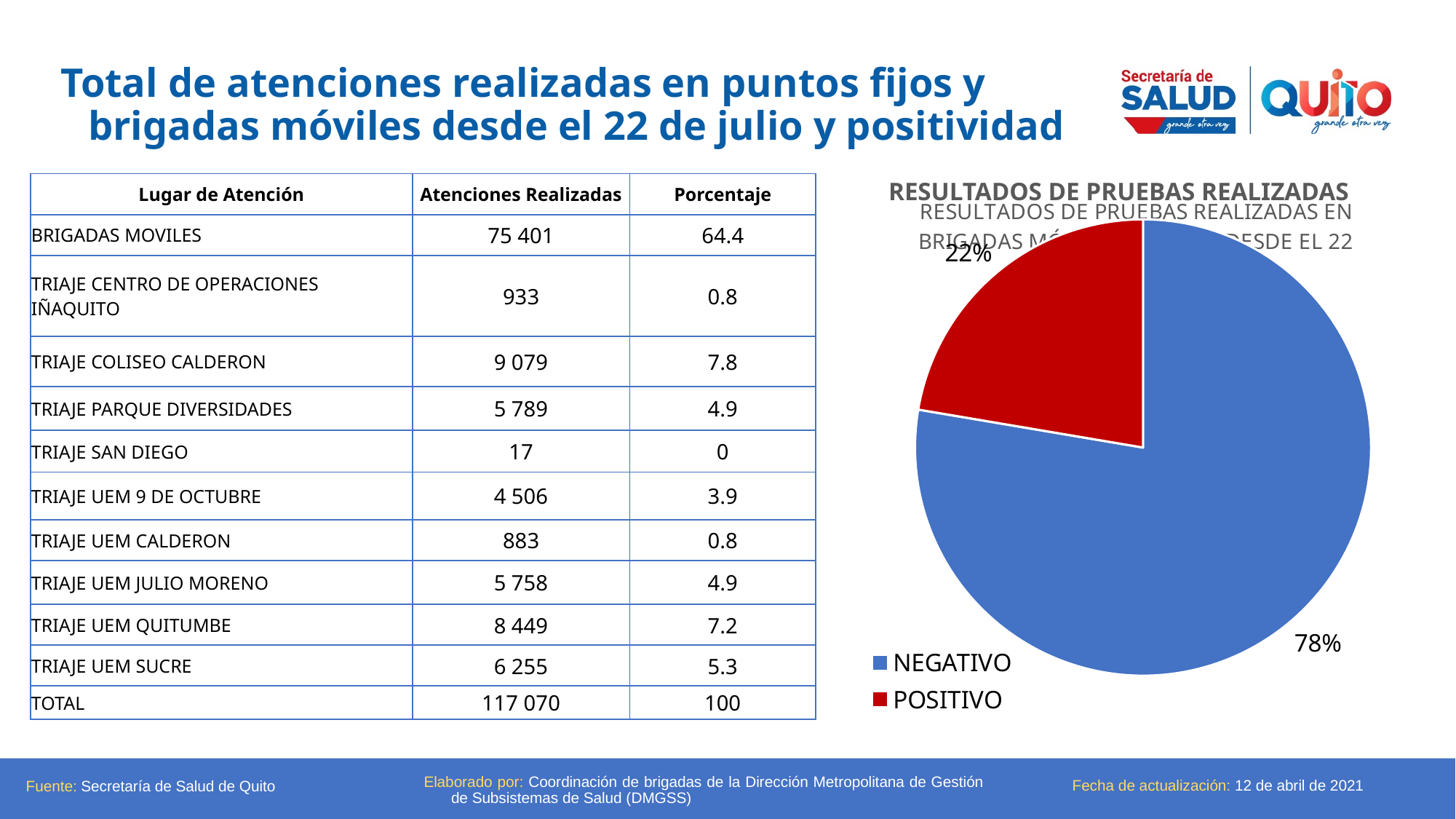
How many entries does the pie chart legend list? 2 What kind of chart is shown on the slide? pie chart Which slice of the pie chart is the smallest? POSITIVO What share of the pie chart does NEGATIVO represent? 78% What is the title of the pie chart? RESULTADOS DE PRUEBAS REALIZADAS Which slice of the pie chart is the largest? NEGATIVO What share of the pie chart does POSITIVO represent? 22% What is the difference in percentage points between the NEGATIVO and POSITIVO slices? 56 What colour is the POSITIVO slice in the pie chart? red Which is larger in the pie chart, NEGATIVO or POSITIVO? NEGATIVO How many slices does the pie chart have? 2